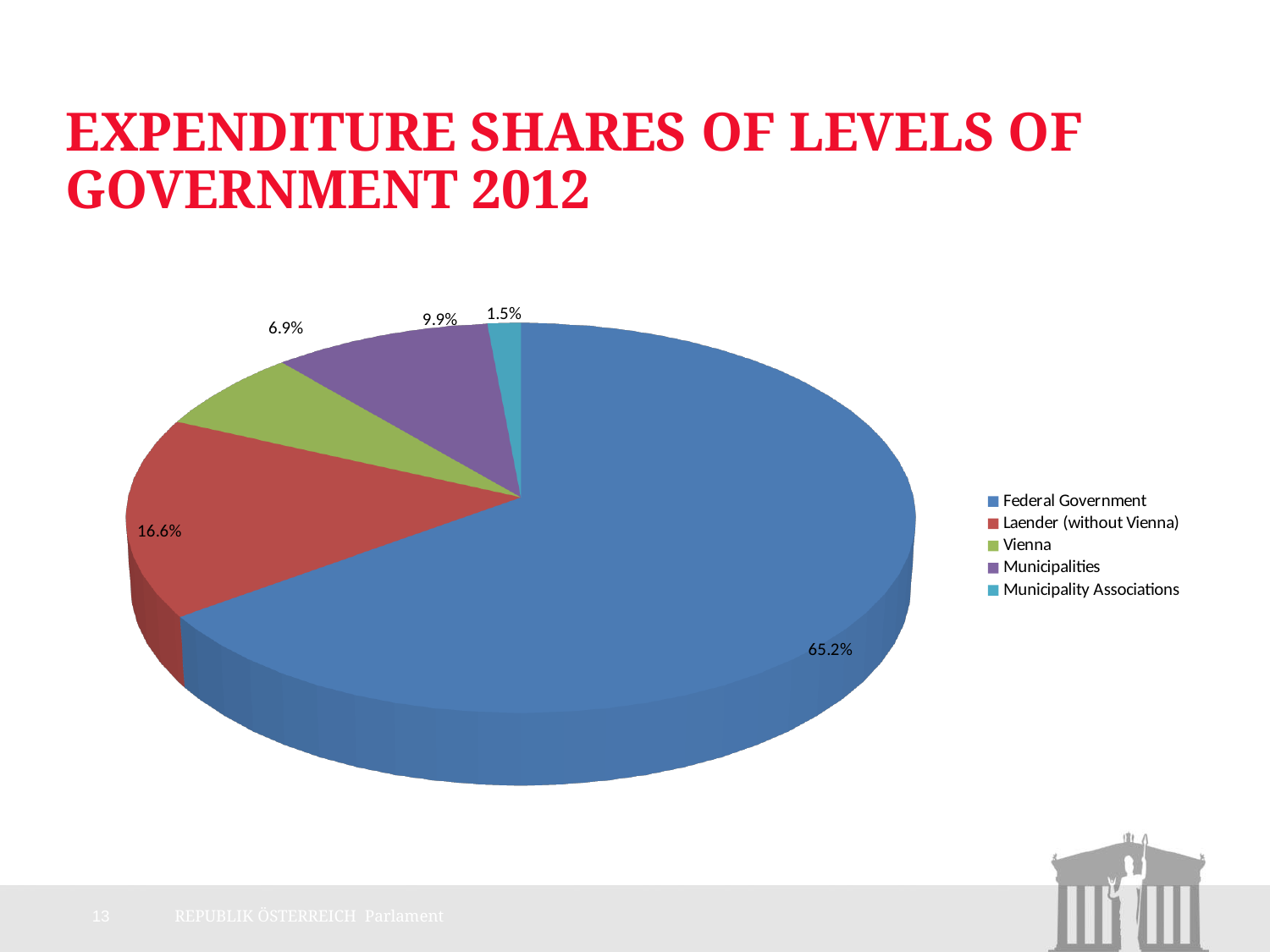
What share of expenditure does the Federal Government have? 65.2% What share of expenditure do the Municipalities have? 9.9% What share of expenditure does Vienna have? 6.9% Which level of government has the largest expenditure share? Federal Government Which level of government has the smallest expenditure share? Municipality Associations Which has a larger expenditure share, Vienna or Municipalities? Municipalities What kind of chart is shown on the slide? Pie chart What is the title of the chart on the slide? Expenditure Shares of Levels of Government 2012 How many levels of government are shown in the pie chart? 5 What share of expenditure do the Laender (without Vienna) have? 16.6% What share of expenditure do the Municipality Associations have? 1.5% What is the difference between the expenditure shares of the Federal Government and the Laender (without Vienna)? 48.6%